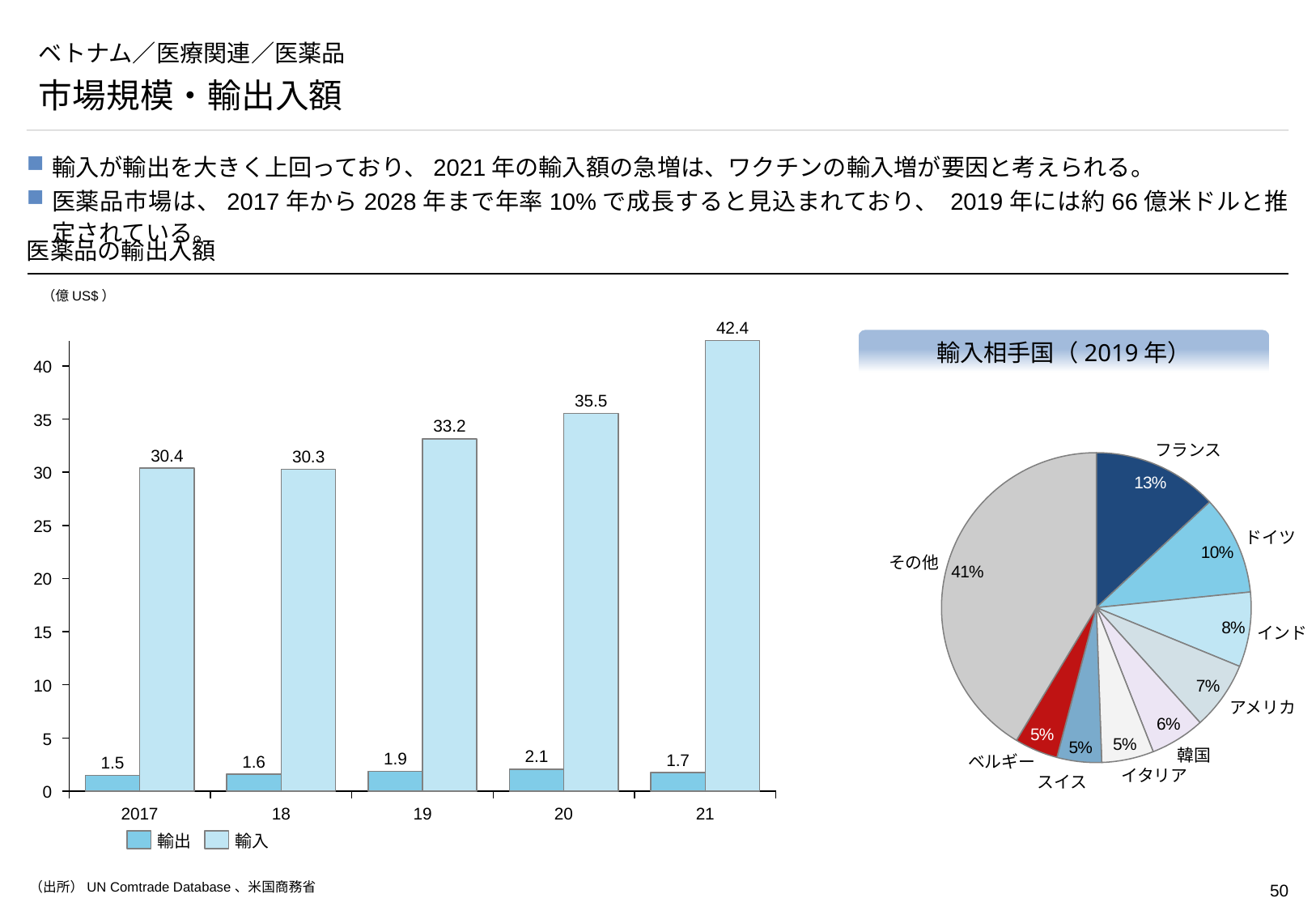
What kind of chart is 輸入相手国（2019年）? pie chart In the bar chart 医薬品の輸出入額, which year has the lowest 輸入 value? 18 In the bar chart 医薬品の輸出入額, which year has the highest 輸出 value? 20 In the pie chart 輸入相手国（2019年）, which category has the largest share? その他 In the pie chart 輸入相手国（2019年）, what share does フランス have? 13% In the bar chart 医薬品の輸出入額, which is larger: 輸出 for 19 or 輸出 for 21? 輸出 for 19 In the bar chart 医薬品の輸出入額, does the 輸入 value rise or fall from 18 to 21? rise In the bar chart 医薬品の輸出入額, what is the value of 輸出 for 2017? 1.5 In the bar chart 医薬品の輸出入額, what is the difference between the 輸入 values for 21 and 20? 6.9 In the pie chart 輸入相手国（2019年）, how many slices are there? 9 In the bar chart 医薬品の輸出入額, how many series does the legend list? 2 In the bar chart 医薬品の輸出入額, what is the value of 輸入 for 21? 42.4